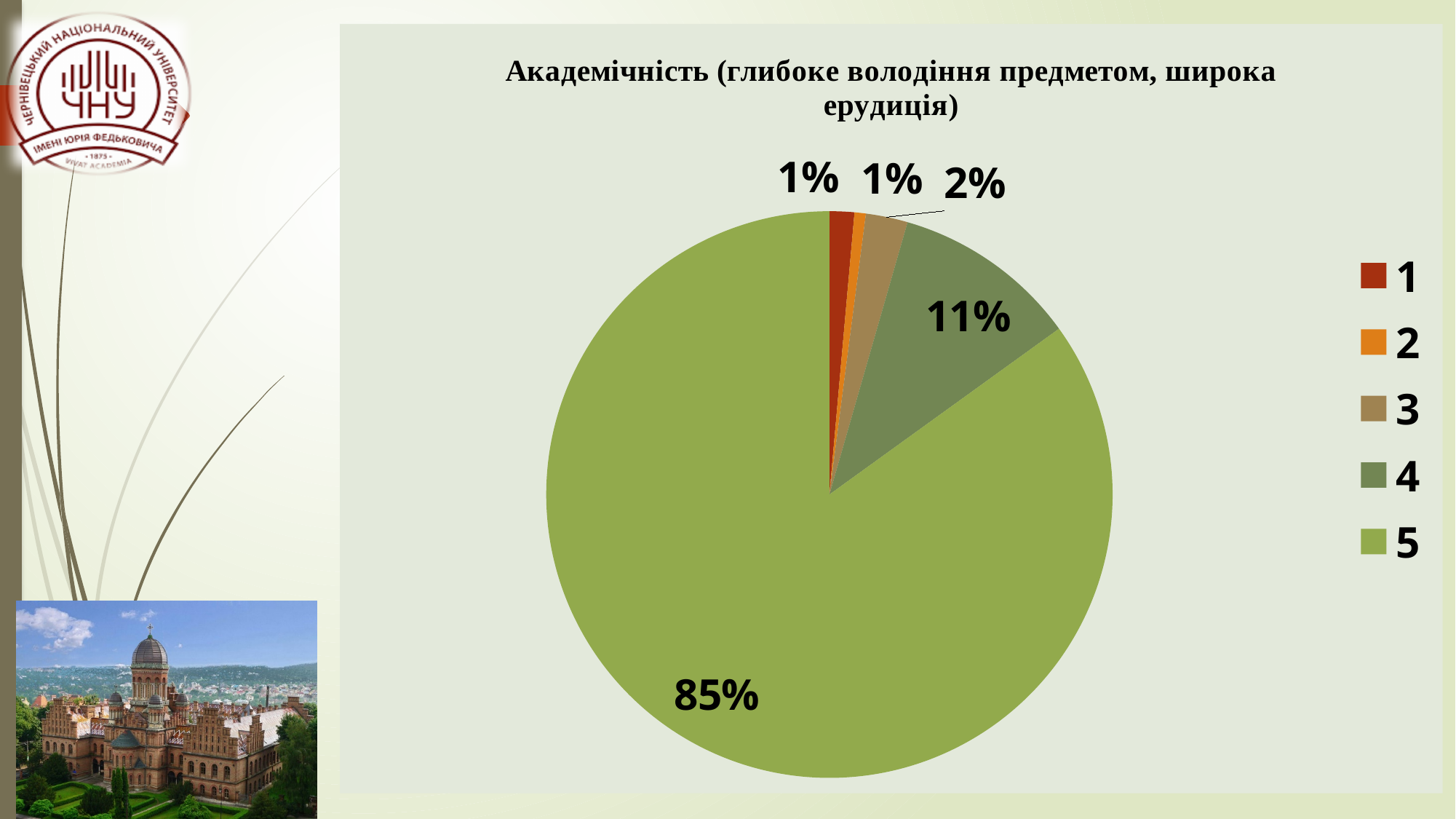
Which category has the largest slice of the pie? 5 What share of the pie does category 1 have? 1% What kind of chart is shown on the slide? pie chart What is the combined share of categories 1, 2 and 3? 4% What share of the pie does category 5 have? 85% What share of the pie does category 4 have? 11% What colour is the slice for category 2 in the legend? orange What is the title of the chart? Академічність (глибоке володіння предметом, широка ерудиція) What is the difference between the shares of category 5 and category 4? 74% Which is larger, the share for category 4 or the share for category 3? 4 How many categories does the legend list? 5